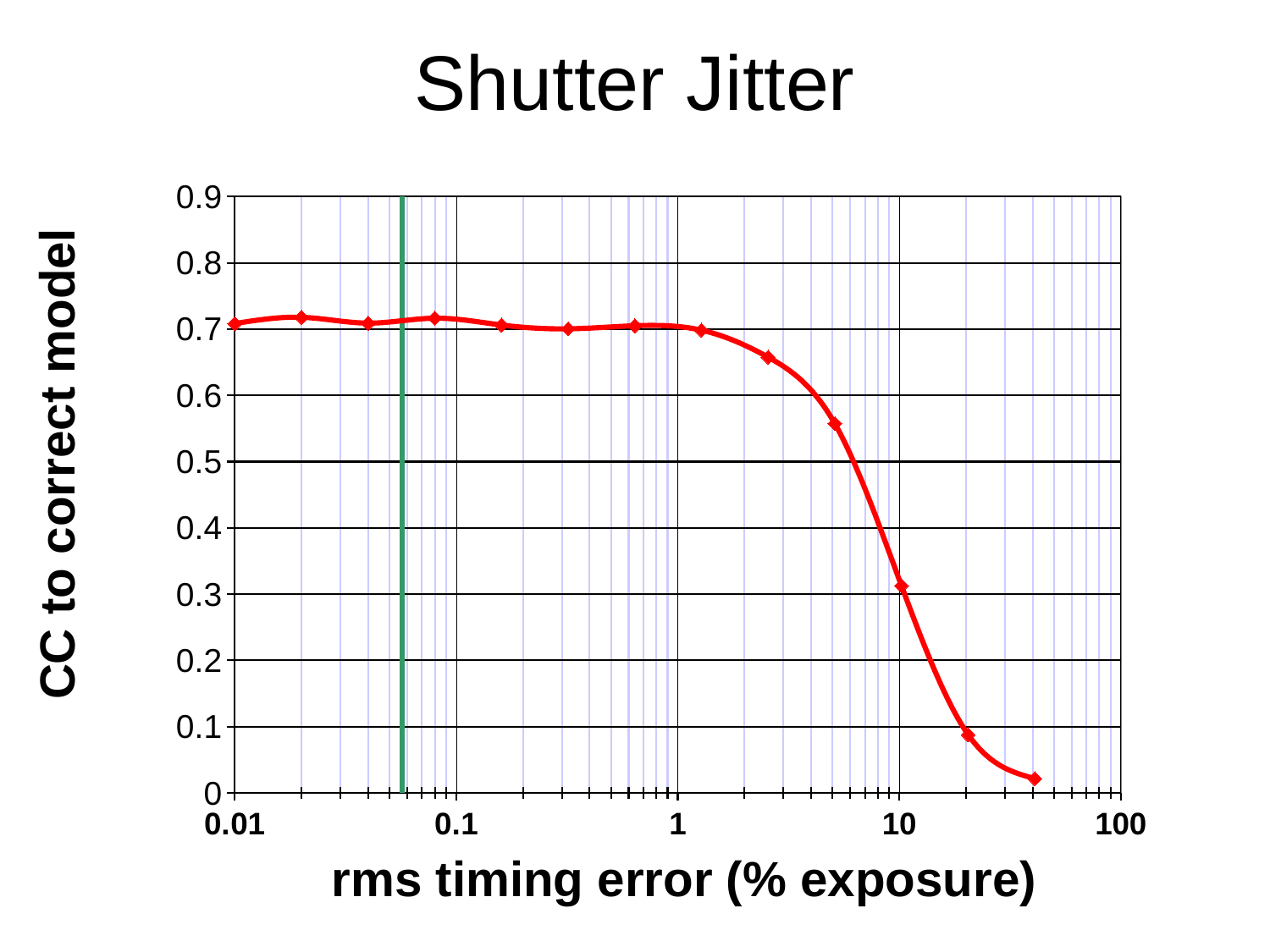
What kind of chart is shown on the slide? line chart What is the title of the chart? Shutter Jitter Which is larger: the CC to correct model at an rms timing error of 1% exposure or at 10% exposure? 1% exposure What is the label of the x axis? rms timing error (% exposure) What is the highest value shown on the y axis? 0.9 How many data points are plotted on the line? 13 Is the CC to correct model at an rms timing error of about 40% exposure greater or less than 0.1? less Does the CC to correct model rise or fall as the rms timing error increases beyond 1% exposure? fall Is the CC to correct model at an rms timing error of about 5% exposure greater or less than 0.5? greater Is the CC to correct model at an rms timing error of 0.01% exposure greater or less than 0.6? greater